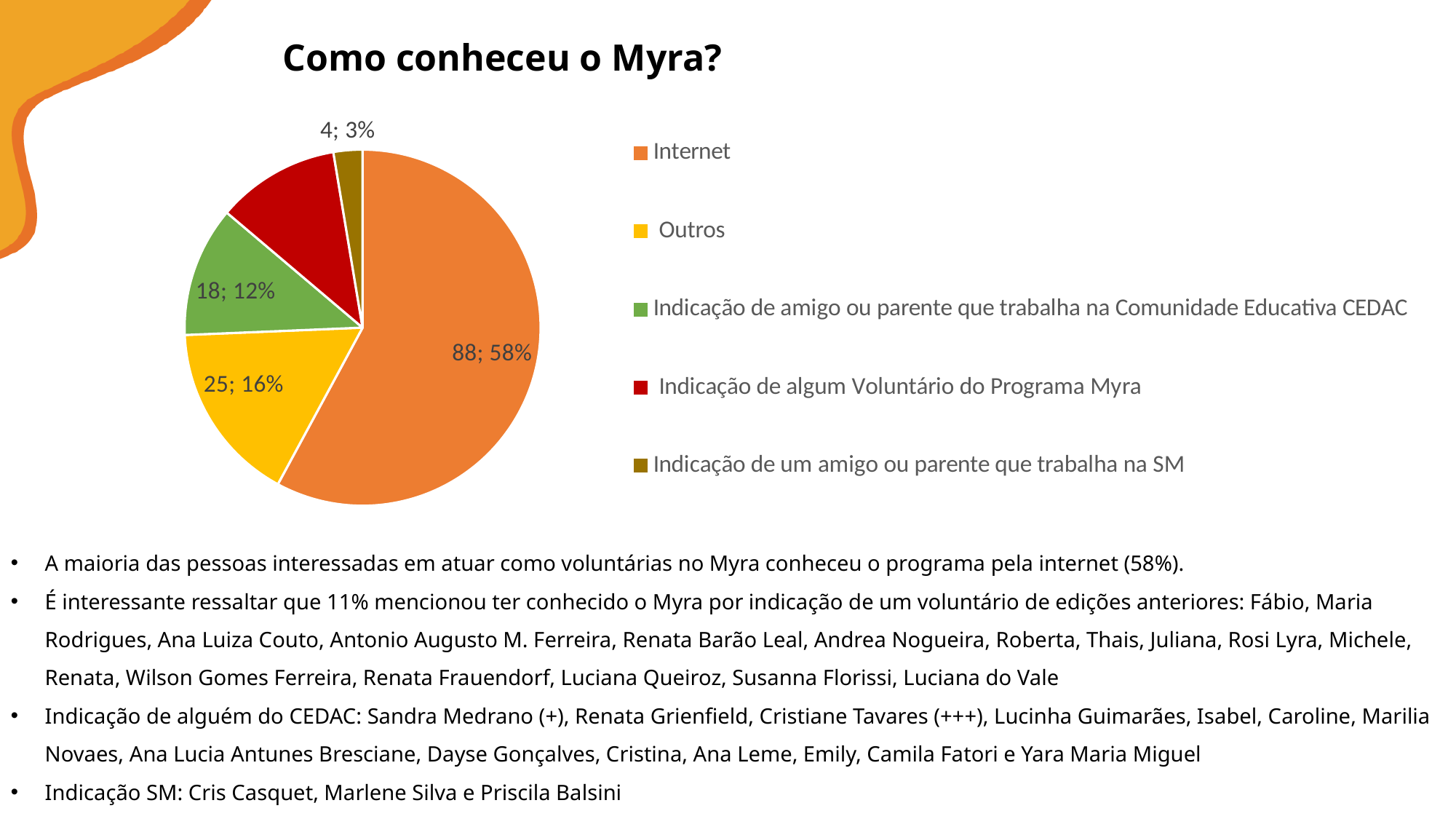
What is the count for Outros? 25 What is the difference between the counts for Internet and Outros? 63 Which category has the smallest slice? Indicação de um amigo ou parente que trabalha na SM What share of the pie does Outros represent? 16% What share of the pie does Internet represent? 58% Which category has the largest slice? Internet What is the title of the chart? Como conheceu o Myra? What is the count for Indicação de um amigo ou parente que trabalha na SM? 4 What is the count for Indicação de amigo ou parente que trabalha na Comunidade Educativa CEDAC? 18 How many categories does the legend list? 5 What is the count for Internet? 88 What type of chart is shown on the slide? pie chart